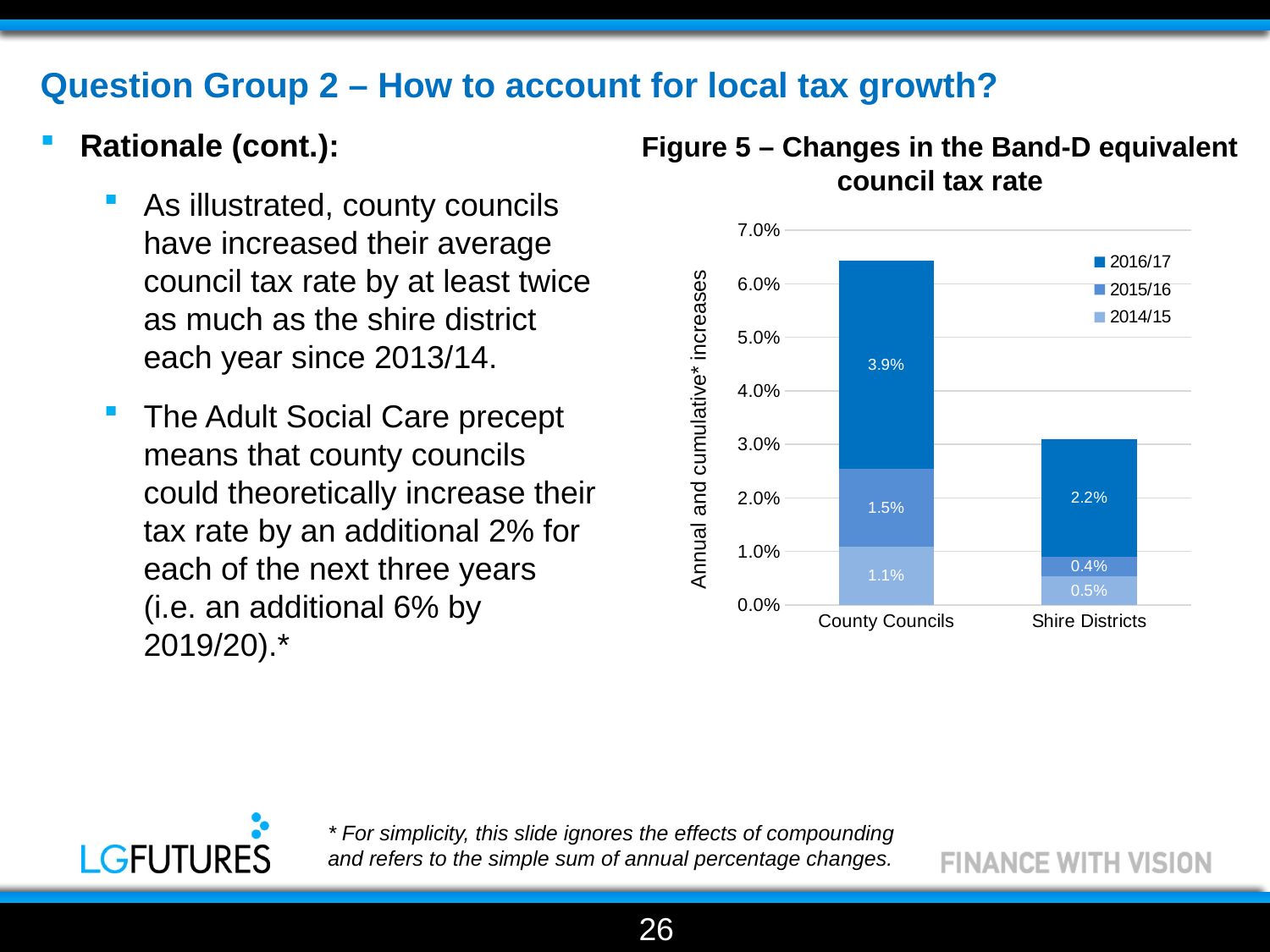
What is the 2016/17 value for County Councils? 3.9% What is the 2015/16 value for Shire Districts? 0.4% What is the total of the stacked bar for County Councils? 6.5% What is the title of the chart? Figure 5 – Changes in the Band-D equivalent council tax rate What is the 2015/16 value for County Councils? 1.5% What is the difference between the 2016/17 values for County Councils and Shire Districts? 1.7% What is the total of the stacked bar for Shire Districts? 3.1% How many series does the legend list? 3 Which category has the higher 2014/15 value, County Councils or Shire Districts? County Councils What type of chart is shown in Figure 5? Stacked bar chart How many categories are shown on the x axis? 2 What is the 2014/15 value for Shire Districts? 0.5%